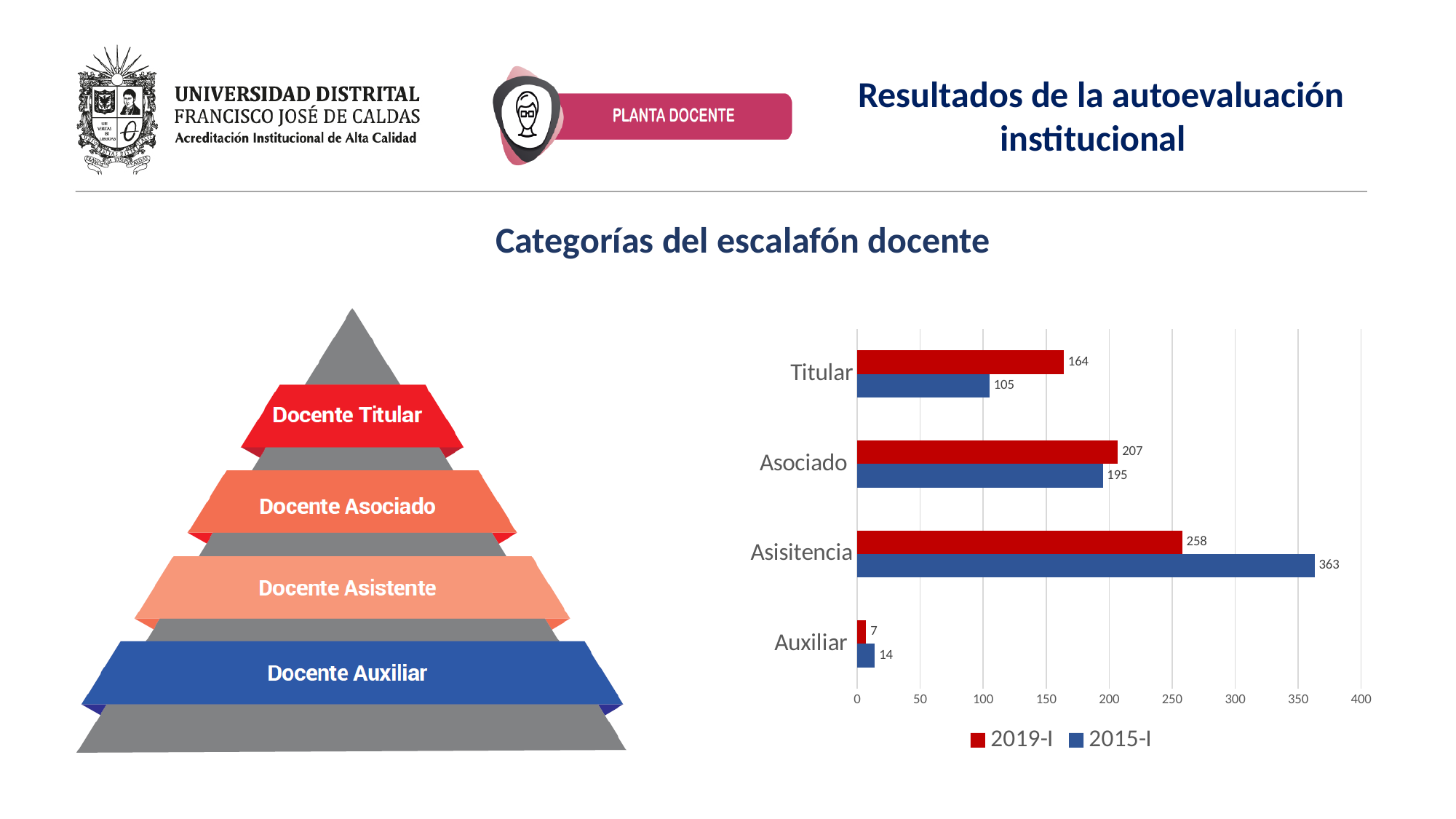
Which category has the highest value in the 2015-I series? Asisitencia What kind of chart is shown on the right of the slide? Bar chart Which is larger for Asociado, the 2019-I value or the 2015-I value? 2019-I Which category has the lowest value in the 2019-I series? Auxiliar What is the value for Titular in the 2019-I series? 164 What is the value for Asociado in the 2015-I series? 195 How many categories are shown on the bar chart? 4 How many series does the legend of the bar chart list? 2 What is the difference between the 2019-I and 2015-I values for Titular? 59 What is the value for Auxiliar in the 2019-I series? 7 What is the difference between the 2015-I and 2019-I values for Asisitencia? 105 What is the value for Asisitencia in the 2015-I series? 363